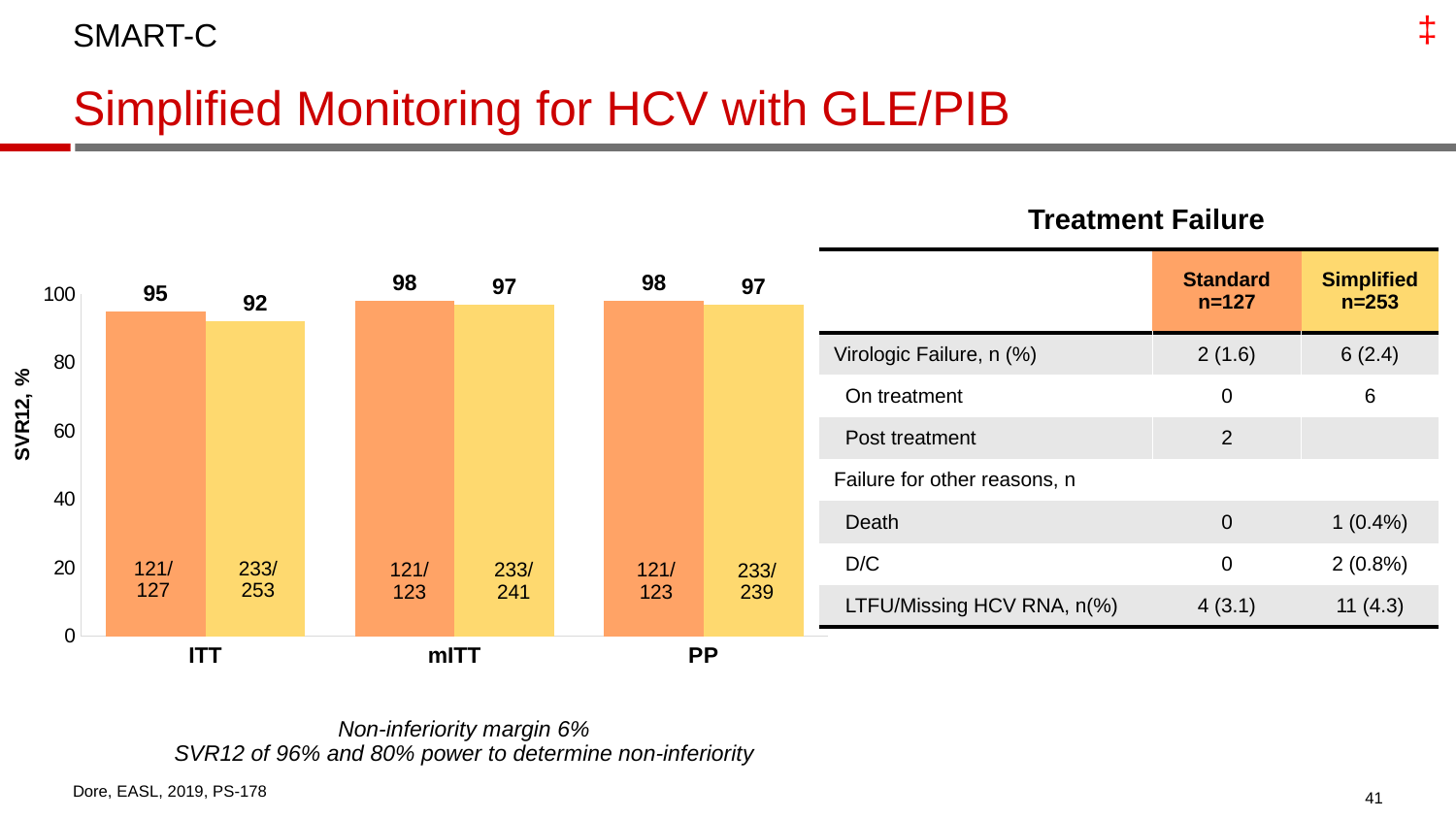
What is the SVR12 value shown on the orange bar for mITT? 98 What is the SVR12 value shown on the orange bar for ITT? 95 What fraction is printed inside the yellow bar for mITT? 233/241 Which category has the lowest SVR12 value on the yellow bars? ITT What is the label of the y axis of the bar chart? SVR12, % For PP, which bar is larger, the orange bar or the yellow bar? orange bar What is the SVR12 value shown on the yellow bar for PP? 97 What kind of chart is shown on the slide? bar chart What is the difference between the orange and yellow bar values for ITT? 3 What fraction is printed inside the orange bar for ITT? 121/127 How many categories are shown on the x axis of the bar chart? 3 What is the SVR12 value shown on the yellow bar for ITT? 92